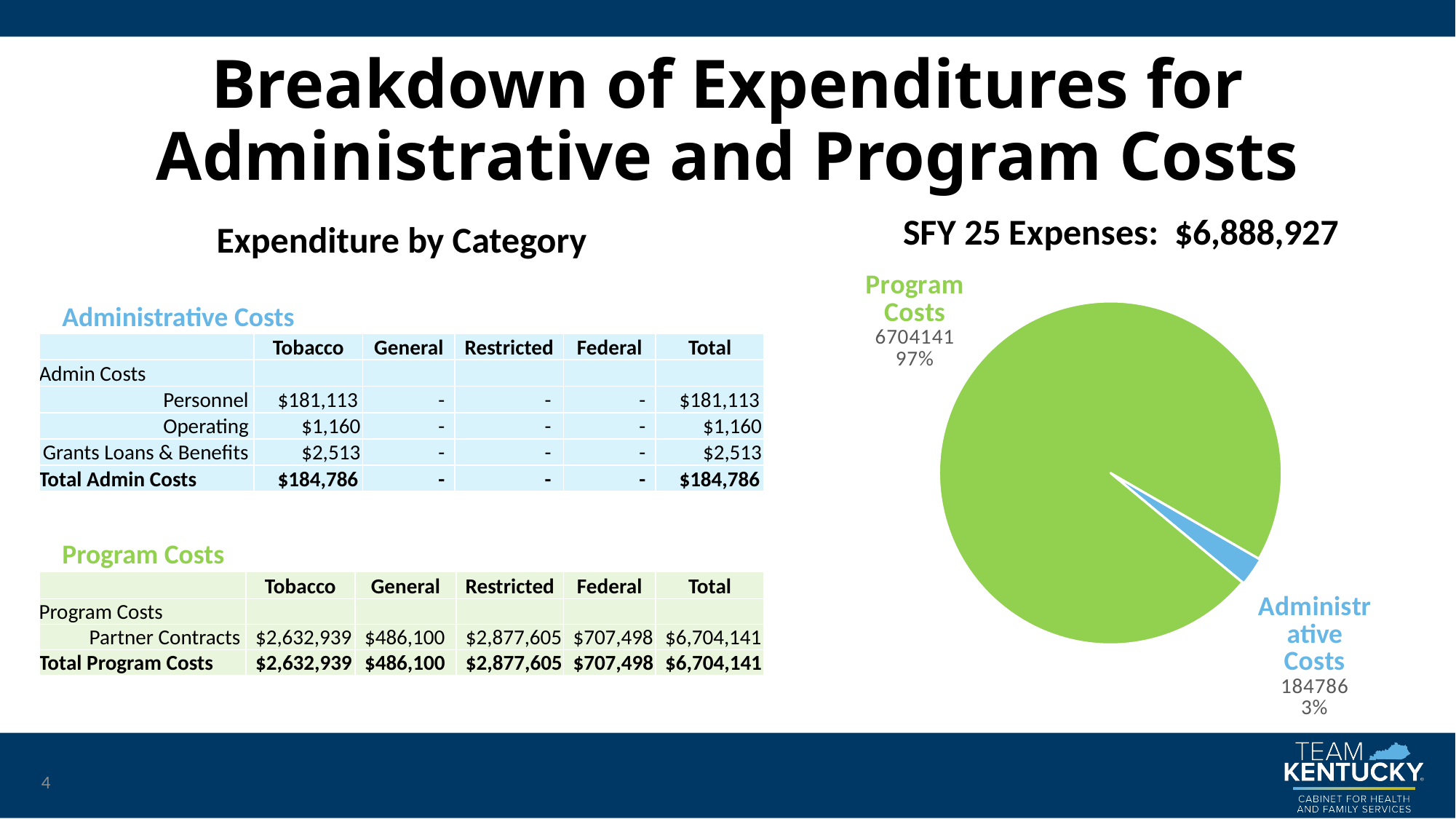
What share of the pie chart is Administrative Costs? 3% What is the difference between the Program Costs value and the Administrative Costs value in the pie chart? 6519355 In the pie chart, which is larger: Program Costs or Administrative Costs? Program Costs What value is shown for Program Costs in the pie chart? 6704141 What value is shown for Administrative Costs in the pie chart? 184786 What colour is the Program Costs slice in the pie chart? green What share of the pie chart is Program Costs? 97% What kind of chart is shown on the slide? pie chart How many slices does the pie chart have? 2 Which slice of the pie chart is the smallest? Administrative Costs What is the title shown above the pie chart? SFY 25 Expenses: $6,888,927 Which slice of the pie chart is the largest? Program Costs